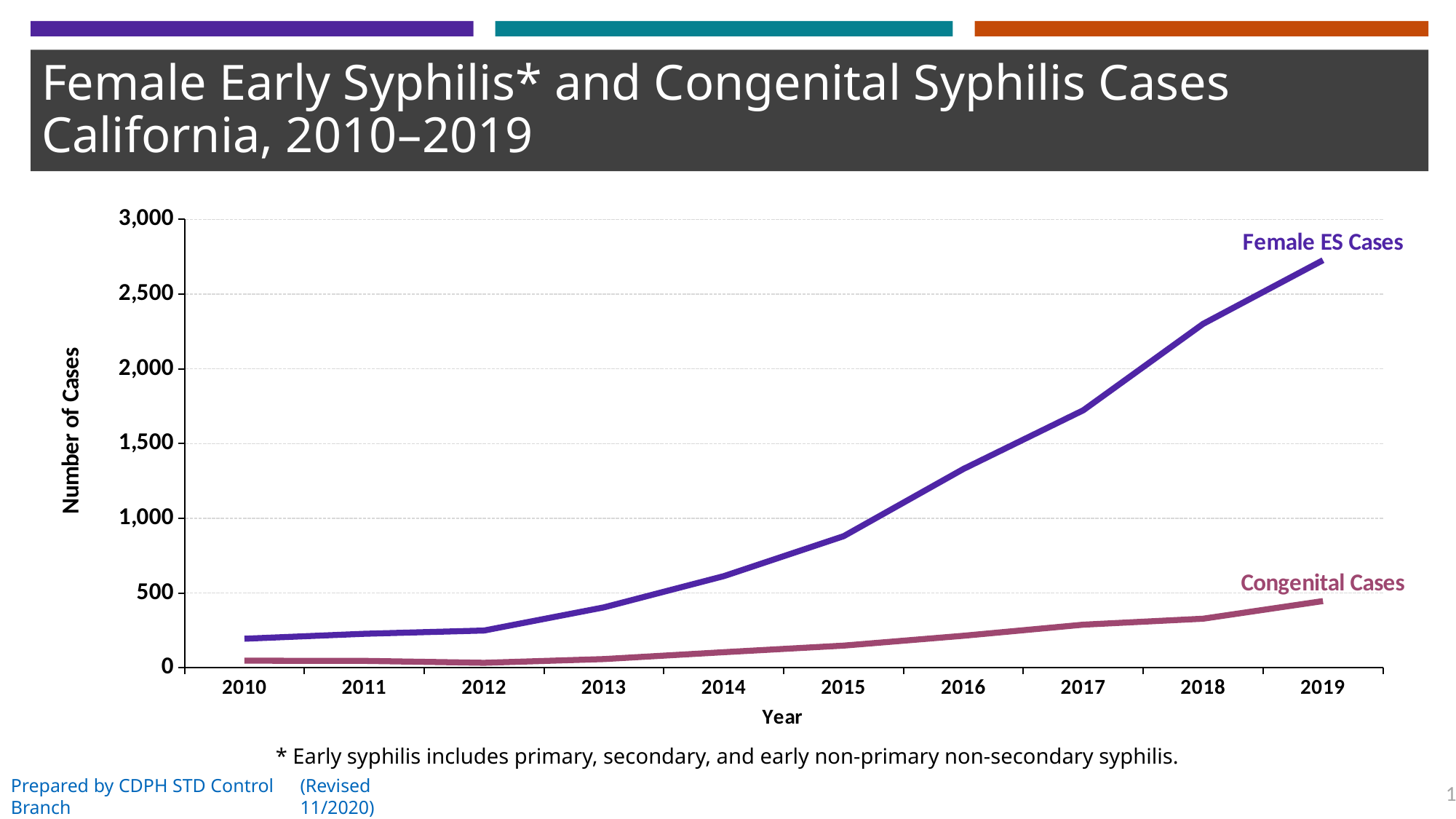
Is the value for Female ES Cases in 2015 greater or less than 1,000? less What kind of chart is shown on the slide? line chart What is the label on the vertical axis of the chart? Number of Cases In which year are Female ES Cases highest? 2019 Is the value for Congenital Cases in 2019 greater or less than 500? less In which year are Congenital Cases highest? 2019 Is the value for Female ES Cases in 2018 greater or less than 2,000? greater How many years are shown along the x axis? 10 Do Female ES Cases rise or fall from 2010 to 2019? rise How many series are plotted on the chart? 2 In 2019, which series has the larger value, Female ES Cases or Congenital Cases? Female ES Cases